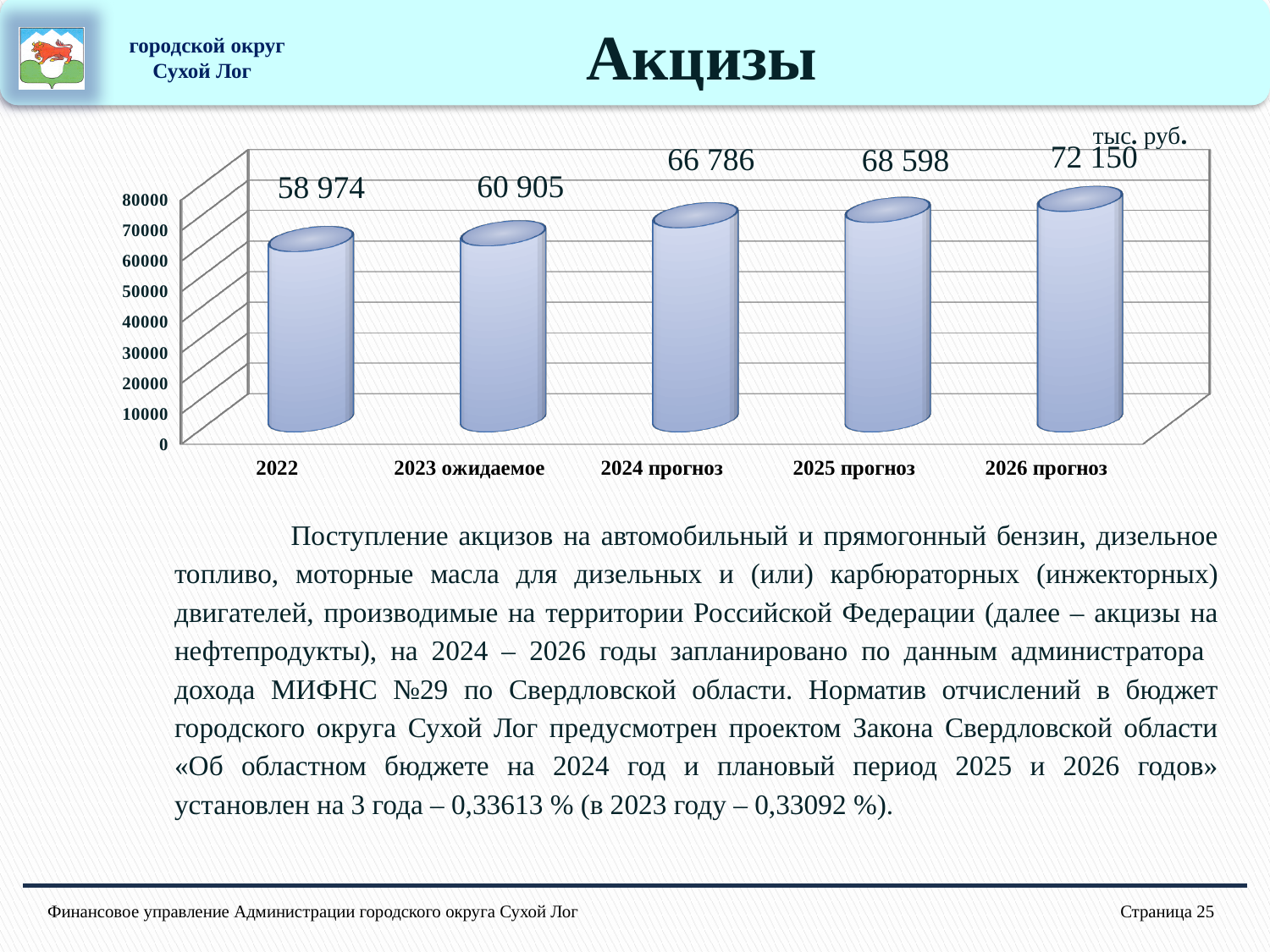
What is the value for 2026 прогноз? 72 150 What is the difference between the values for 2025 прогноз and 2024 прогноз? 1 812 What is the value for 2024 прогноз? 66 786 Which category has the lowest value? 2022 How many categories are shown on the x axis of the chart? 5 What unit is indicated for the chart values? тыс. руб. Do the values rise or fall from 2022 to 2026 прогноз? rise What is the value for 2023 ожидаемое? 60 905 What is the value for 2022 on the chart? 58 974 Which is larger, the value for 2023 ожидаемое or the value for 2025 прогноз? 2025 прогноз Which category has the highest value? 2026 прогноз What is the difference between the values for 2026 прогноз and 2022? 13 176